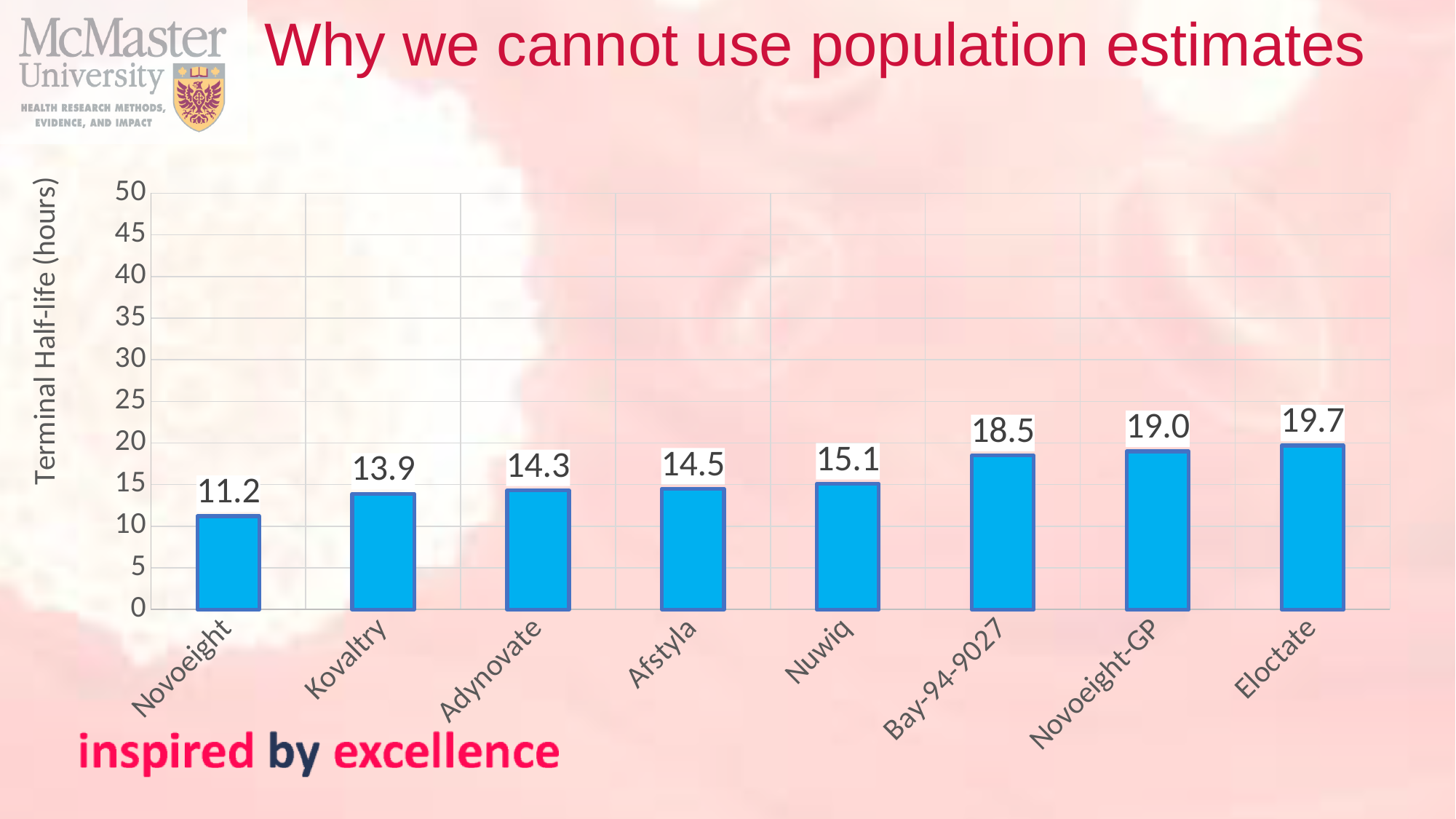
What is the terminal half-life for Novoeight? 11.2 Which has a longer terminal half-life, Adynovate or Bay-94-9027? Bay-94-9027 What is the difference in terminal half-life between Novoeight-GP and Kovaltry? 5.1 Which product has the lowest terminal half-life? Novoeight What kind of chart is shown on the slide? bar chart Which product has the highest terminal half-life? Eloctate What is the terminal half-life for Nuwiq? 15.1 What is the difference in terminal half-life between Eloctate and Novoeight? 8.5 Is the value for Afstyla greater or less than 20? less How many products are shown on the chart? 8 What is the label of the vertical axis? Terminal Half-life (hours) What is the terminal half-life for Bay-94-9027? 18.5